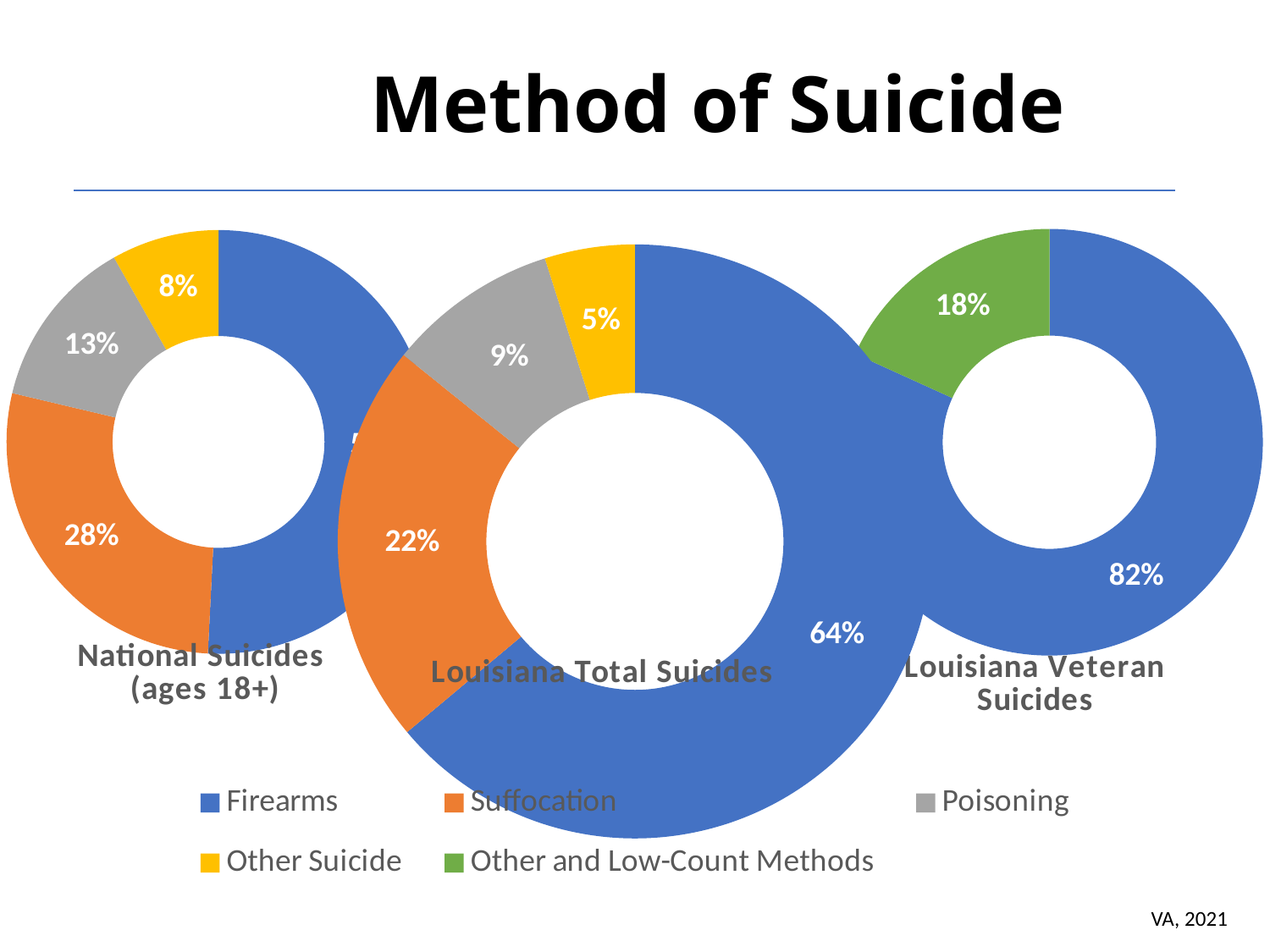
In the Louisiana Veteran Suicides chart, what share is Other and Low-Count Methods? 18% In the Louisiana Veteran Suicides chart, what share is Firearms? 82% In the Louisiana Total Suicides chart, what share is Poisoning? 9% Which is larger: the Suffocation share in the National Suicides (ages 18+) chart or the Suffocation share in the Louisiana Total Suicides chart? National Suicides (ages 18+) In the National Suicides (ages 18+) chart, what share is Other Suicide? 8% In the Louisiana Total Suicides chart, what is the difference between the Firearms share and the Suffocation share? 42% In the Louisiana Total Suicides chart, which method has the largest share? Firearms In the Louisiana Total Suicides chart, which method has the smallest share? Other Suicide In the National Suicides (ages 18+) chart, what share is Suffocation? 28% In the Louisiana Total Suicides chart, what share is Firearms? 64% How many slices does the Louisiana Veteran Suicides chart have? 2 How many entries does the legend list? 5